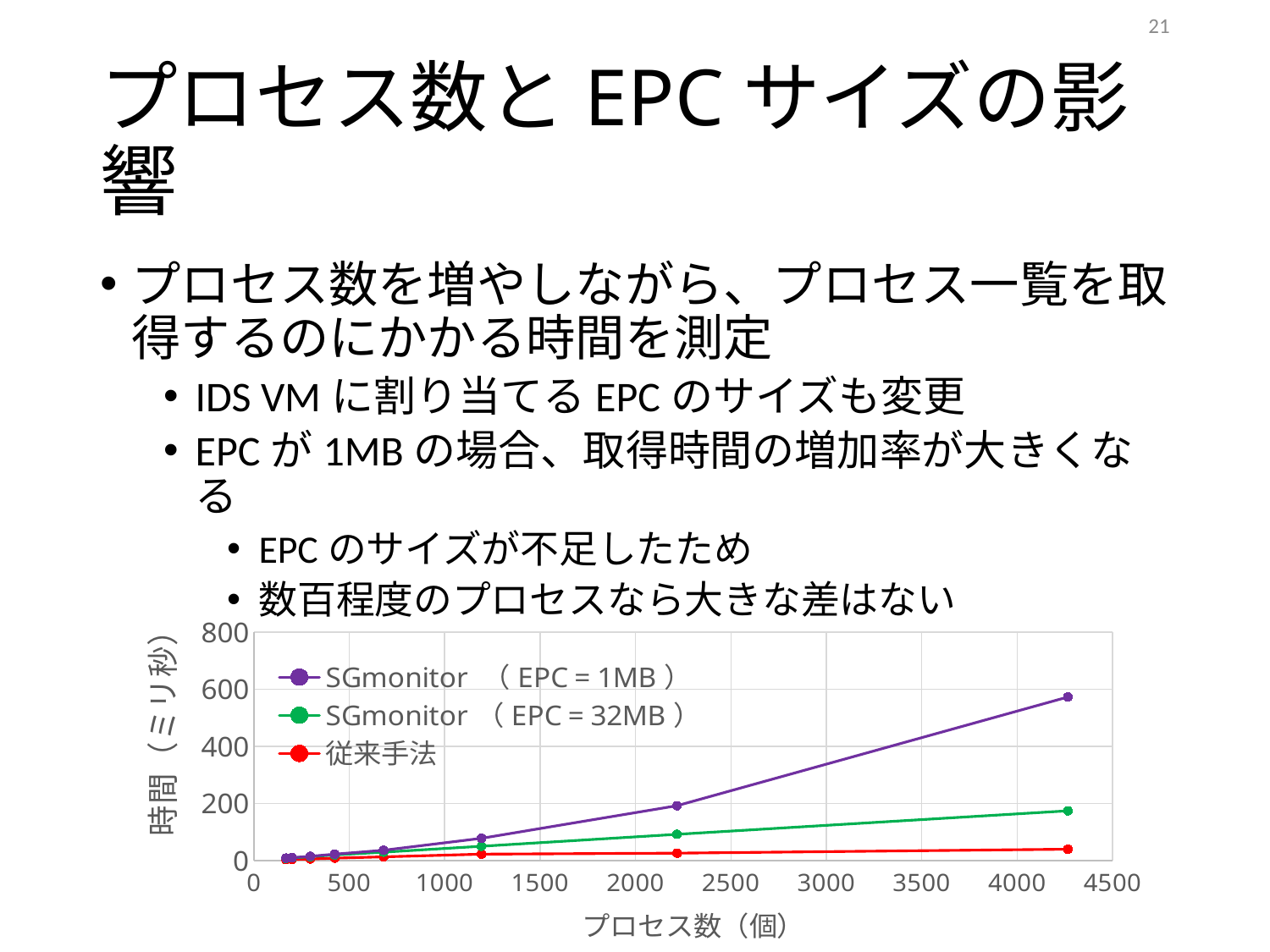
At the largest process count, which is larger: the value for SGmonitor (EPC = 32MB) or the value for 従来手法? SGmonitor （EPC = 32MB） Is the value for SGmonitor (EPC = 1MB) at the largest process count greater or less than 400? greater Is the value for SGmonitor (EPC = 32MB) at the largest process count greater or less than 400? less Does the time for SGmonitor (EPC = 1MB) rise or fall as the number of processes increases? rise Is the value for SGmonitor (EPC = 1MB) at around 2200 processes greater or less than 400? less What kind of chart is shown on the slide? line chart How many series does the chart legend list? 3 Which series has the lowest value at the largest process count on the chart? 従来手法 What is the label of the chart's y axis? 時間（ミリ秒） What is the label of the chart's x axis? プロセス数（個） Which series has the highest value at the largest process count on the chart? SGmonitor （EPC = 1MB）